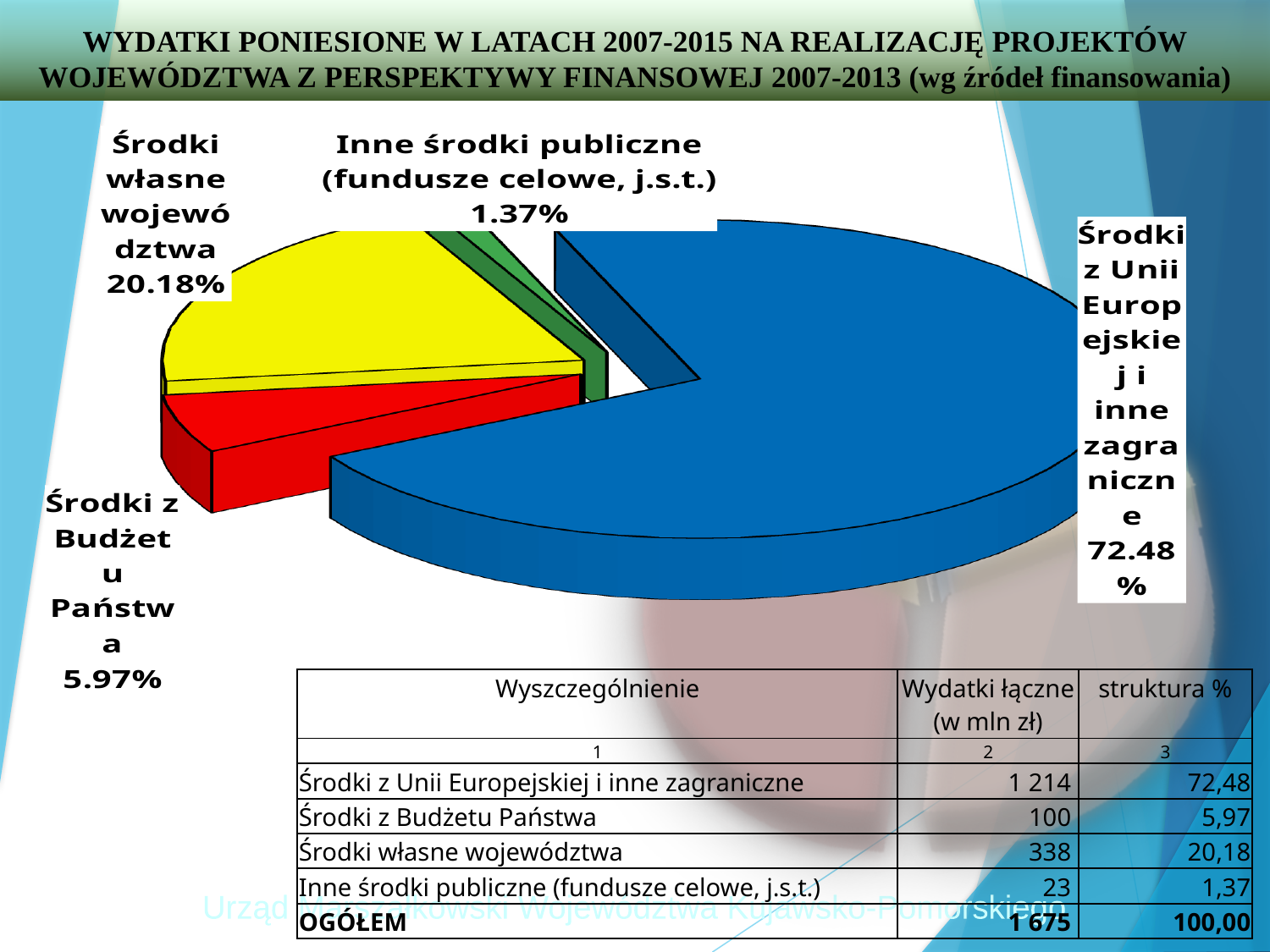
What share of the pie does "Środki z Unii Europejskiej i inne zagraniczne" represent? 72.48% What colour is the slice for "Środki z Unii Europejskiej i inne zagraniczne" in the pie chart? blue What type of chart is shown on the slide? pie chart What is the value shown for "Inne środki publiczne (fundusze celowe, j.s.t.)" in the pie chart? 1.37% What is the value shown for "Środki z Budżetu Państwa" in the pie chart? 5.97% What is the difference in percentage points between "Środki z Budżetu Państwa" and "Inne środki publiczne (fundusze celowe, j.s.t.)" in the pie chart? 4.60% Which is larger in the pie chart: "Środki własne województwa" or "Środki z Budżetu Państwa"? Środki własne województwa How many slices does the pie chart have? 4 What is the difference in percentage points between "Środki z Unii Europejskiej i inne zagraniczne" and "Środki własne województwa" in the pie chart? 52.30% Which category has the largest slice in the pie chart? Środki z Unii Europejskiej i inne zagraniczne Which category has the smallest slice in the pie chart? Inne środki publiczne (fundusze celowe, j.s.t.) What is the value shown for "Środki własne województwa" in the pie chart? 20.18%